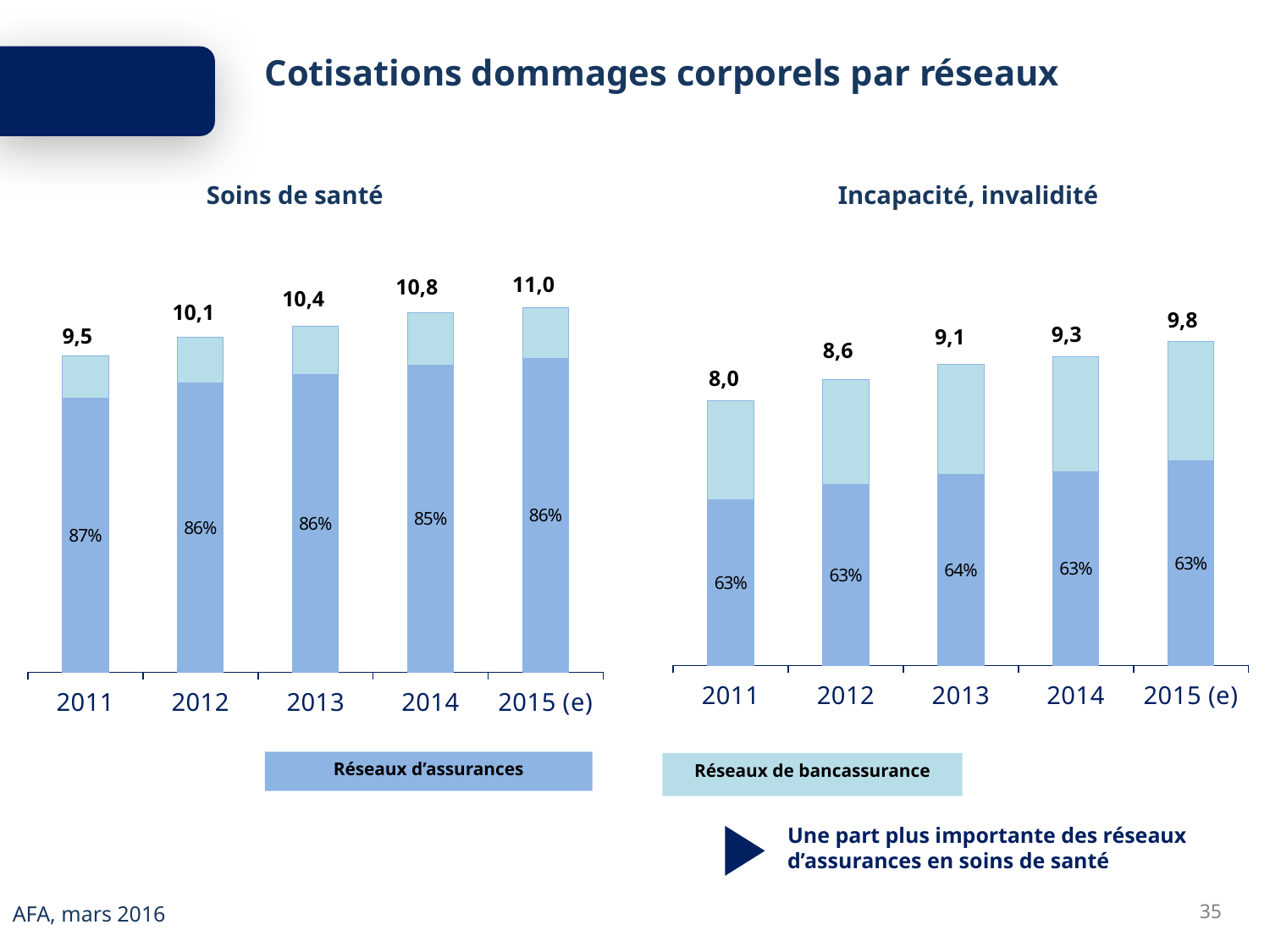
In the 'Soins de santé' chart, what is the difference between the total for 2015 (e) and the total for 2011? 1,5 In the 'Incapacité, invalidité' chart, which year has the lowest total value? 2011 In the 'Incapacité, invalidité' chart, what is the total value printed above the bar for 2011? 8,0 How many series does the legend list for the charts? 2 How many years are shown on the x axis of the 'Soins de santé' chart? 5 In the 'Soins de santé' chart, what is the total value printed above the bar for 2013? 10,4 Do the total values in the 'Incapacité, invalidité' chart rise or fall from 2011 to 2015 (e)? rise In the 'Soins de santé' chart, which year has the highest total value? 2015 (e) In the 'Soins de santé' chart, what percentage is printed inside the Réseaux d'assurances segment for 2011? 87% In the 'Incapacité, invalidité' chart, what is the difference between the total for 2014 and the total for 2012? 0,7 In the 'Incapacité, invalidité' chart, what percentage is printed inside the Réseaux d'assurances segment for 2013? 64% Which is larger: the 2014 total in the 'Soins de santé' chart or the 2014 total in the 'Incapacité, invalidité' chart? Soins de santé